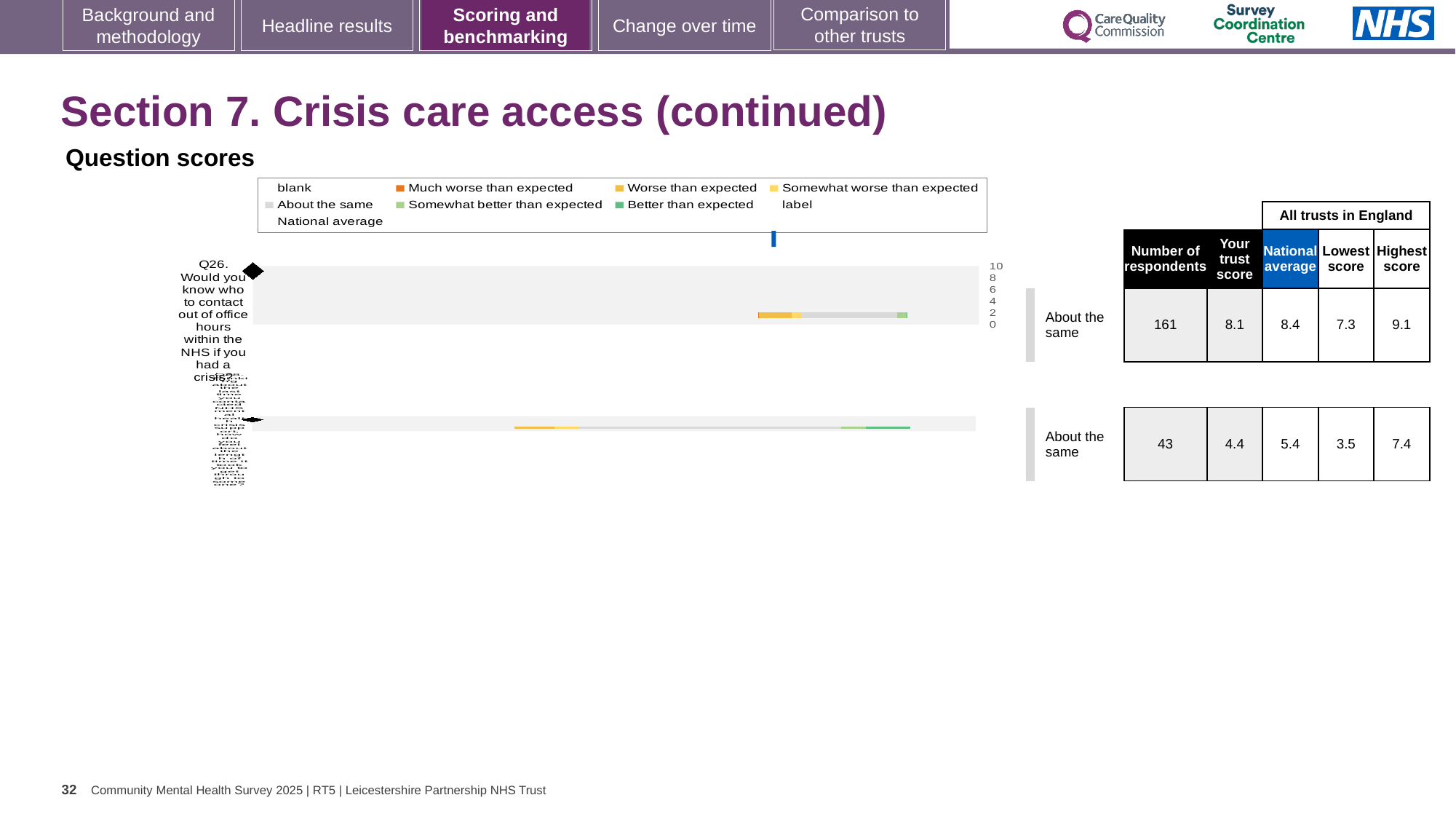
By how much does the national average exceed the trust score for Q26? 0.3 What is the maximum value shown on the chart's score axis? 10 What is the highest score among all trusts in England for Q26? 9.1 What is the difference between the highest and lowest trust scores for Q26? 1.8 What is the trust score for Q26 (Would you know who to contact out of office hours within the NHS if you had a crisis?)? 8.1 For Q26, which is larger: the trust score or the national average? national average What kind of chart is used to show the question scores on this slide? bar chart What benchmark category is Q26 placed in? About the same What is the national average score for Q26? 8.4 How many question rows are plotted in the chart? 2 How many respondents answered Q26? 161 What is the lowest score among all trusts in England for Q26? 7.3